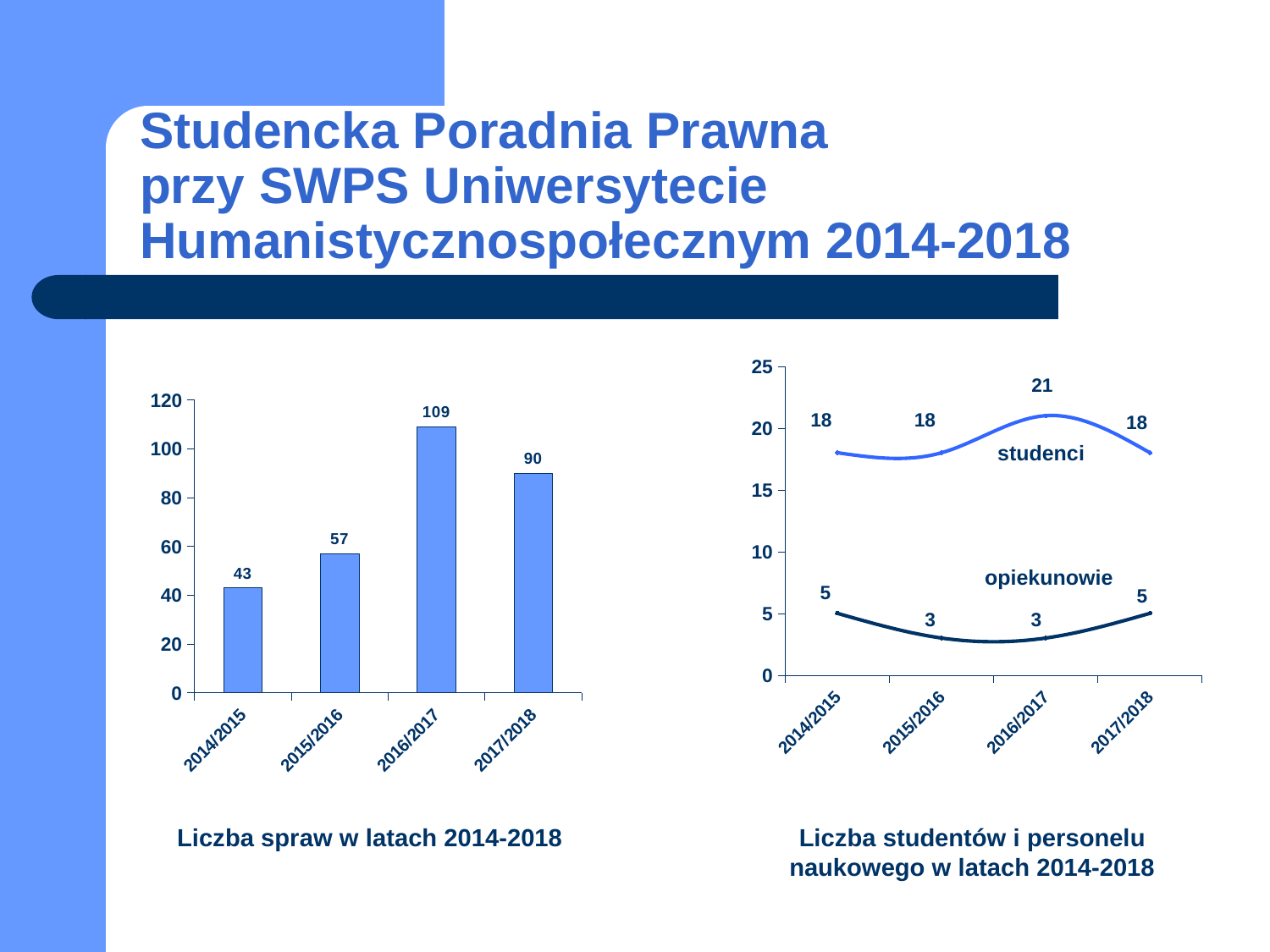
In the left chart (Liczba spraw w latach 2014-2018), what is the difference between the values for 2016/2017 and 2017/2018? 19 In the left chart (Liczba spraw w latach 2014-2018), which year has the lowest value? 2014/2015 What kind of chart is the right chart (Liczba studentów i personelu naukowego w latach 2014-2018)? line chart What kind of chart is the left chart (Liczba spraw w latach 2014-2018)? bar chart In the left chart (Liczba spraw w latach 2014-2018), what is the value for 2016/2017? 109 In the right chart (Liczba studentów i personelu naukowego w latach 2014-2018), what is the value for studenci in 2016/2017? 21 In the right chart (Liczba studentów i personelu naukowego w latach 2014-2018), which is larger in 2014/2015: studenci or opiekunowie? studenci In the right chart (Liczba studentów i personelu naukowego w latach 2014-2018), what is the value for opiekunowie in 2015/2016? 3 In the left chart (Liczba spraw w latach 2014-2018), is the value for 2015/2016 greater or less than 60? less In the right chart (Liczba studentów i personelu naukowego w latach 2014-2018), how many series are plotted? 2 In the right chart (Liczba studentów i personelu naukowego w latach 2014-2018), what is the difference between studenci and opiekunowie in 2016/2017? 18 In the left chart (Liczba spraw w latach 2014-2018), how many bars are there? 4